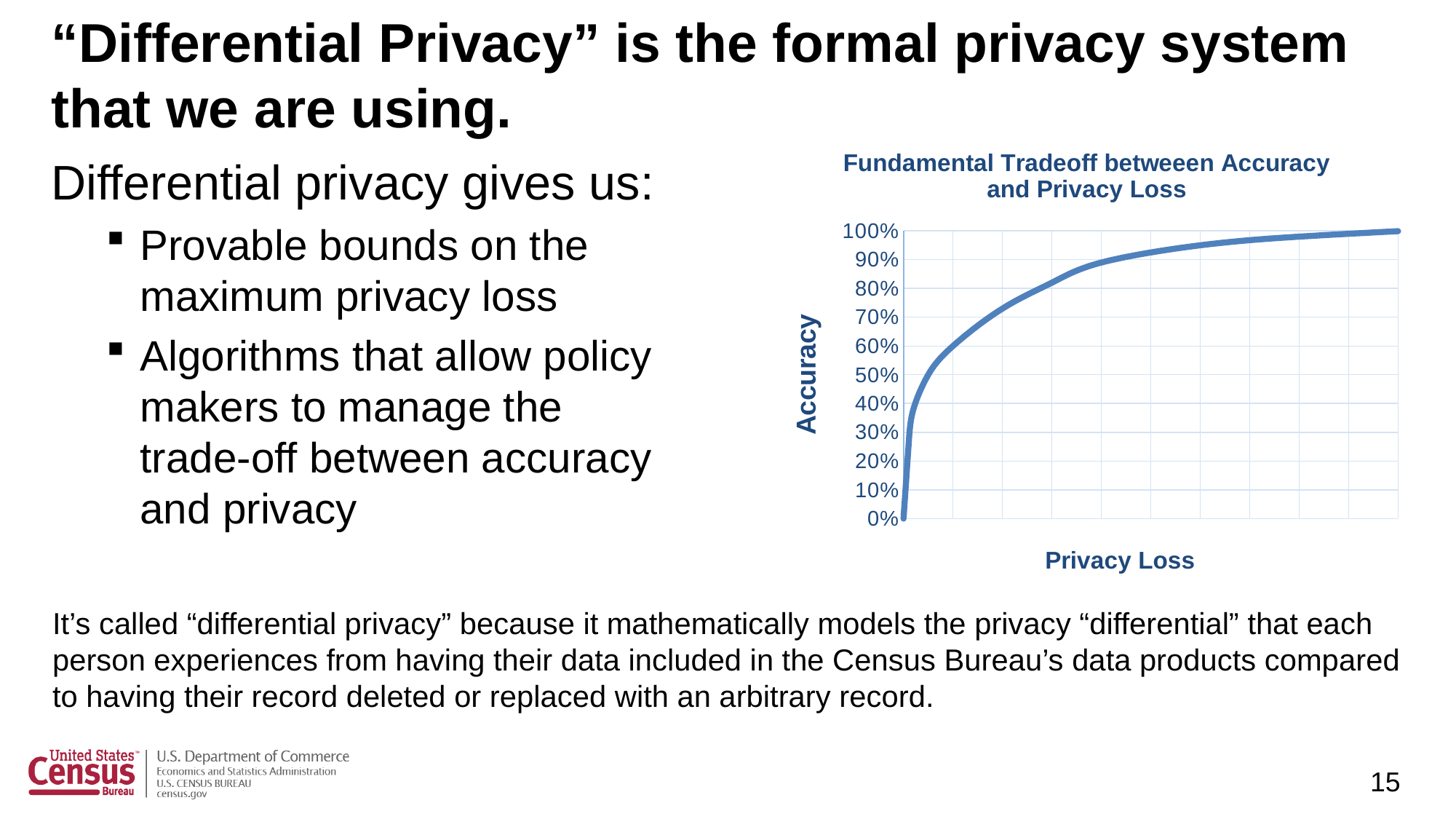
Is the accuracy at the far left end of the curve greater or less than 10%? less What is the label on the vertical axis of the chart? Accuracy Is the accuracy at the far right end of the curve greater or less than 90%? greater What is the highest value shown on the vertical axis of the chart? 100% What kind of chart is shown on the slide? line chart Does accuracy rise or fall as privacy loss increases along the x axis? rise What is the title of the chart? Fundamental Tradeoff betweeen Accuracy and Privacy Loss How many lines are plotted on the chart? 1